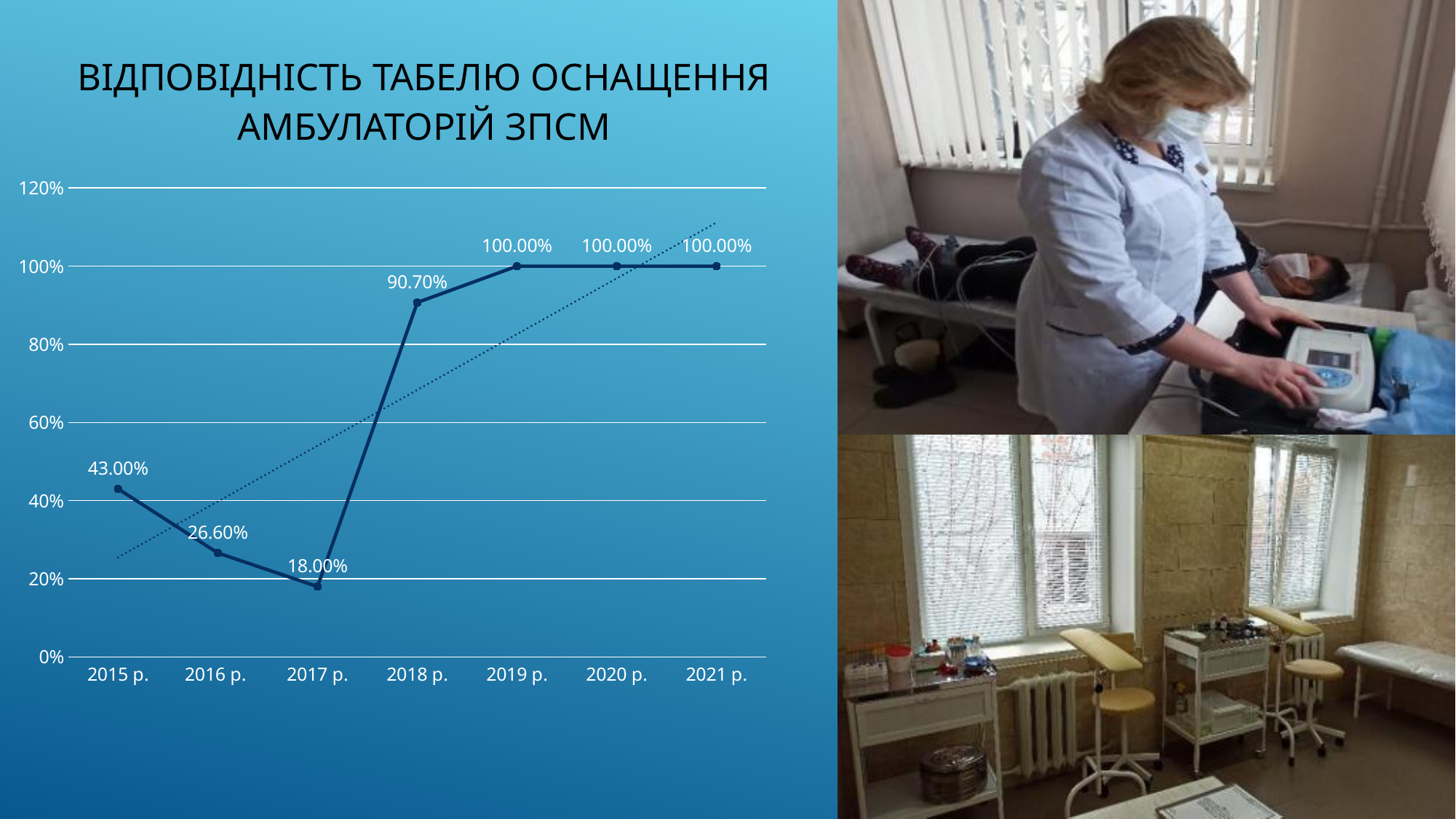
What is the value for 2016 р.? 26.60% What is the value for 2018 р.? 90.70% Is the value for 2018 р. greater or less than 80%? greater Which is larger, the value for 2015 р. or the value for 2016 р.? 2015 р. What is the difference between the values for 2018 р. and 2017 р.? 72.70% What is the value for 2017 р.? 18.00% How many years are plotted on the x axis? 7 What is the difference between the values for 2015 р. and 2016 р.? 16.40% What kind of chart is shown on the slide? line chart Does the value rise or fall from 2017 р. to 2019 р.? rise Which year has the lowest value? 2017 р. What is the value for 2015 р.? 43.00%